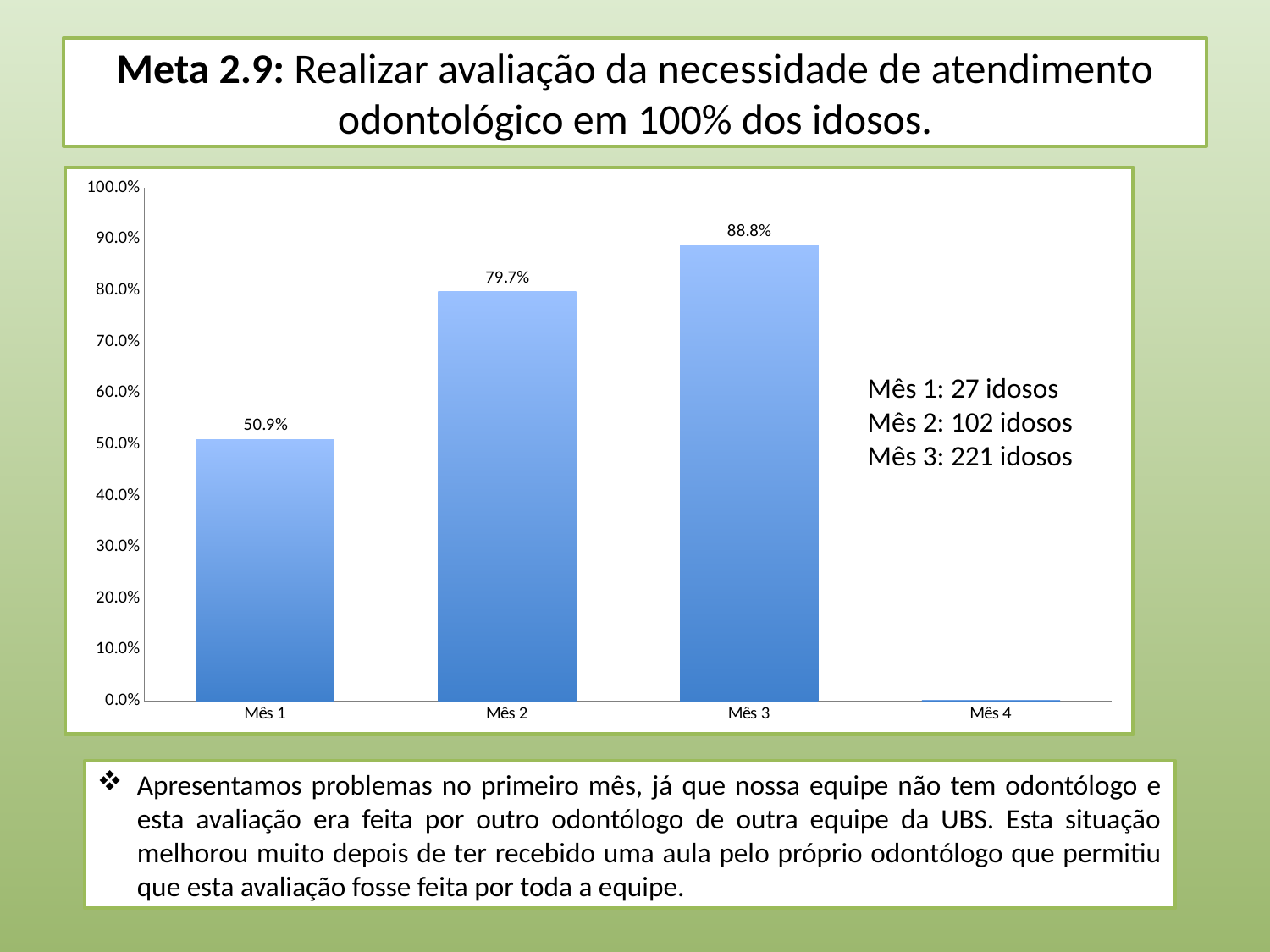
What is the difference between the values for Mês 2 and Mês 1? 28.8 percentage points Which month has the highest value in the chart? Mês 3 Which is larger, the value for Mês 1 or the value for Mês 2? Mês 2 What is the value shown for Mês 1? 50.9% Do the values rise or fall from Mês 1 to Mês 3? Rise What kind of chart is shown on the slide? Bar chart Is the value for Mês 1 greater or less than 60.0%? less What is the value shown for Mês 3? 88.8% How many categories are shown on the x axis of the chart? 4 What is the difference between the values for Mês 3 and Mês 2? 9.1 percentage points What is the value shown for Mês 2? 79.7% Among Mês 1, Mês 2 and Mês 3, which has the lowest value? Mês 1